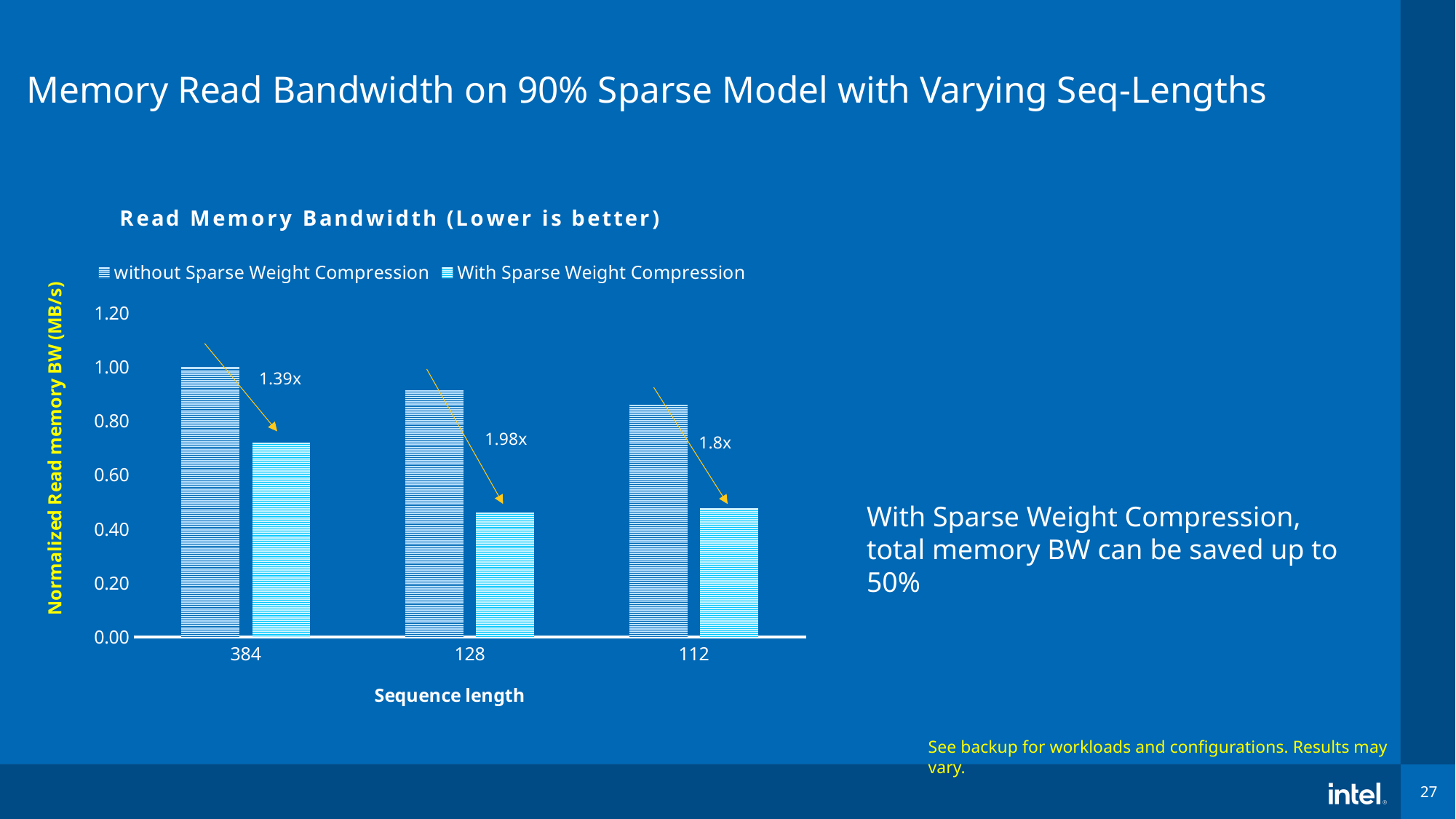
Is the value for 'without Sparse Weight Compression' at sequence length 112 greater or less than 0.80? greater How many sequence-length categories are shown on the x axis? 3 At sequence length 384, which is larger: the bar without Sparse Weight Compression or the bar with Sparse Weight Compression? without Sparse Weight Compression What speedup factor is annotated for sequence length 112? 1.8x What speedup factor is annotated for sequence length 384? 1.39x What is the title of the chart? Read Memory Bandwidth (Lower is better) Which sequence length has the highest annotated speedup factor? 128 What is the label of the y axis? Normalized Read memory BW (MB/s) What speedup factor is annotated for sequence length 128? 1.98x How many series does the legend list? 2 What kind of chart is shown on the slide? bar chart Is the value for 'With Sparse Weight Compression' at sequence length 128 greater or less than 0.60? less